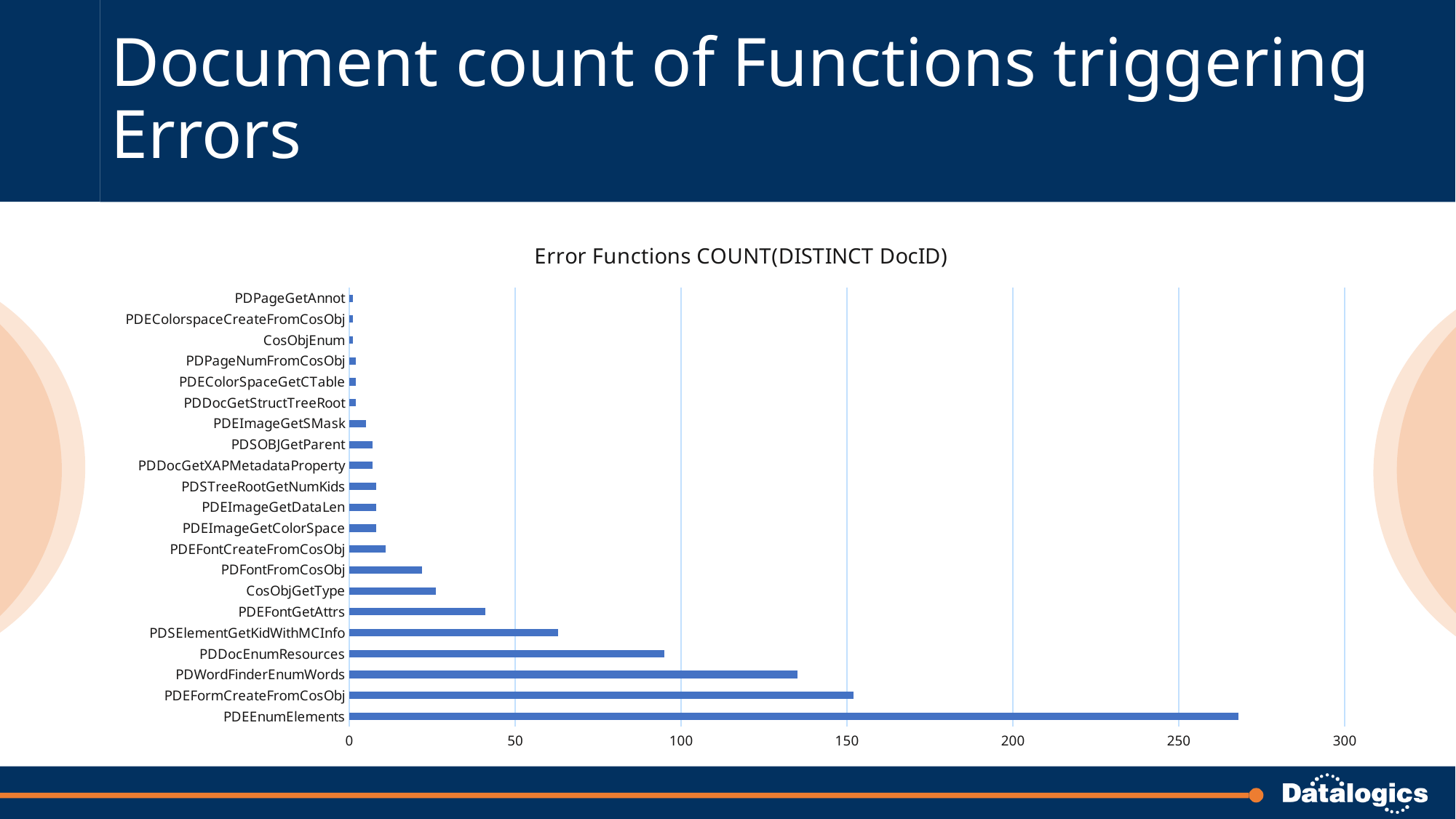
Is the value for PDWordFinderEnumWords greater or less than 150? less Is the value for PDDocEnumResources greater or less than 100? less Which has a larger value, PDEFormCreateFromCosObj or PDWordFinderEnumWords? PDEFormCreateFromCosObj Is the value for PDEFontGetAttrs greater or less than 50? less Which function has the highest document count? PDEEnumElements Do the bar values increase or decrease going from the top of the chart to the bottom? increase How many functions (categories) are plotted in the chart? 21 What kind of chart is shown on the slide? bar chart What is the title of the chart? Error Functions COUNT(DISTINCT DocID) Which has a larger value, CosObjGetType or PDFontFromCosObj? CosObjGetType